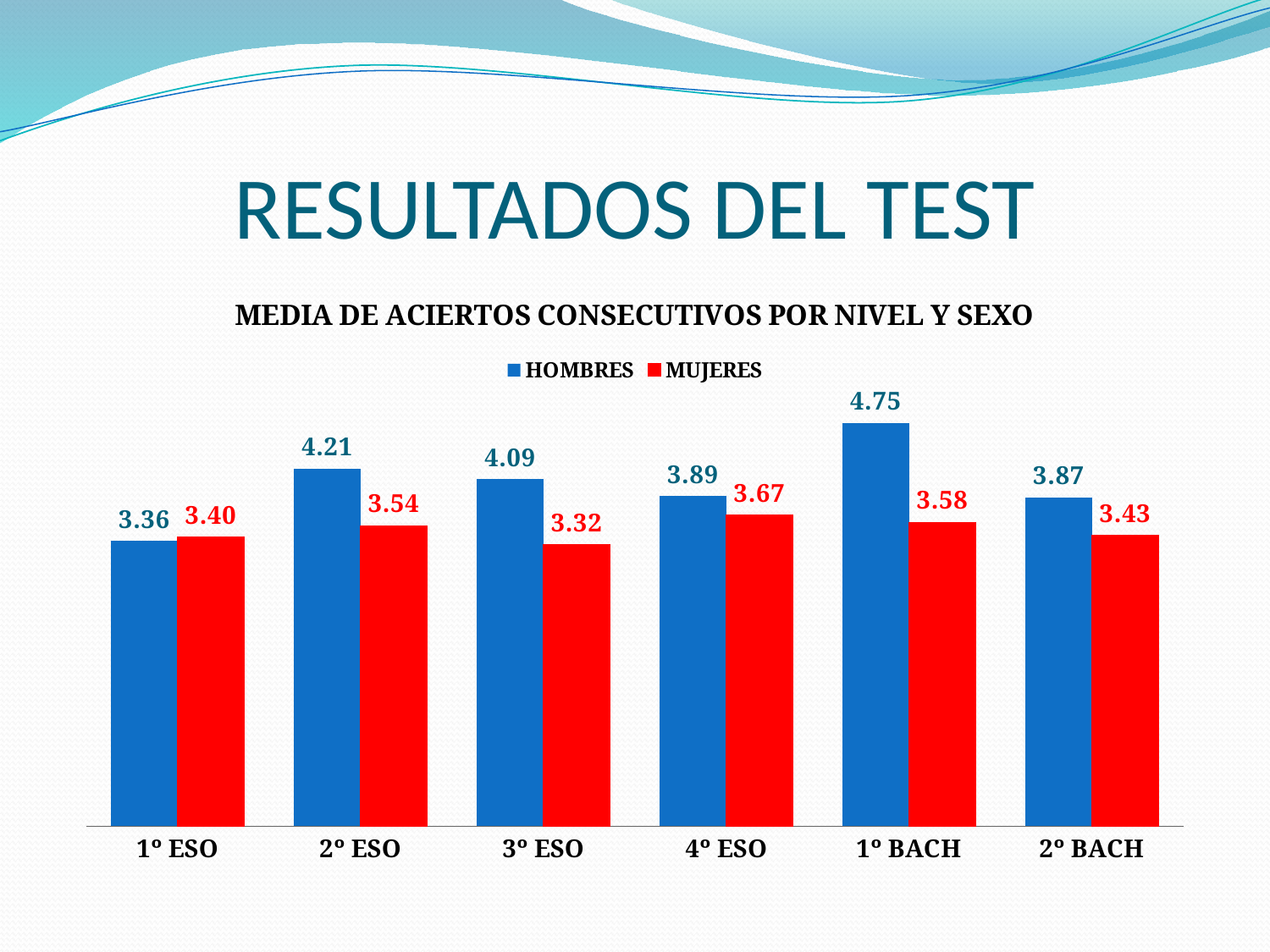
How many categories are shown on the x axis? 6 Which category has the highest MUJERES value? 4º ESO What is the MUJERES value for 3º ESO? 3.32 What is the difference between the HOMBRES and MUJERES values for 1º BACH? 1.17 Which is larger for 1º ESO, the HOMBRES value or the MUJERES value? MUJERES Which category has the highest HOMBRES value? 1º BACH What is the HOMBRES value for 2º ESO? 4.21 What is the HOMBRES value for 1º BACH? 4.75 What is the title of the chart? MEDIA DE ACIERTOS CONSECUTIVOS POR NIVEL Y SEXO Which category has the lowest MUJERES value? 3º ESO What kind of chart is shown on the slide? Bar chart How many series does the legend list? 2